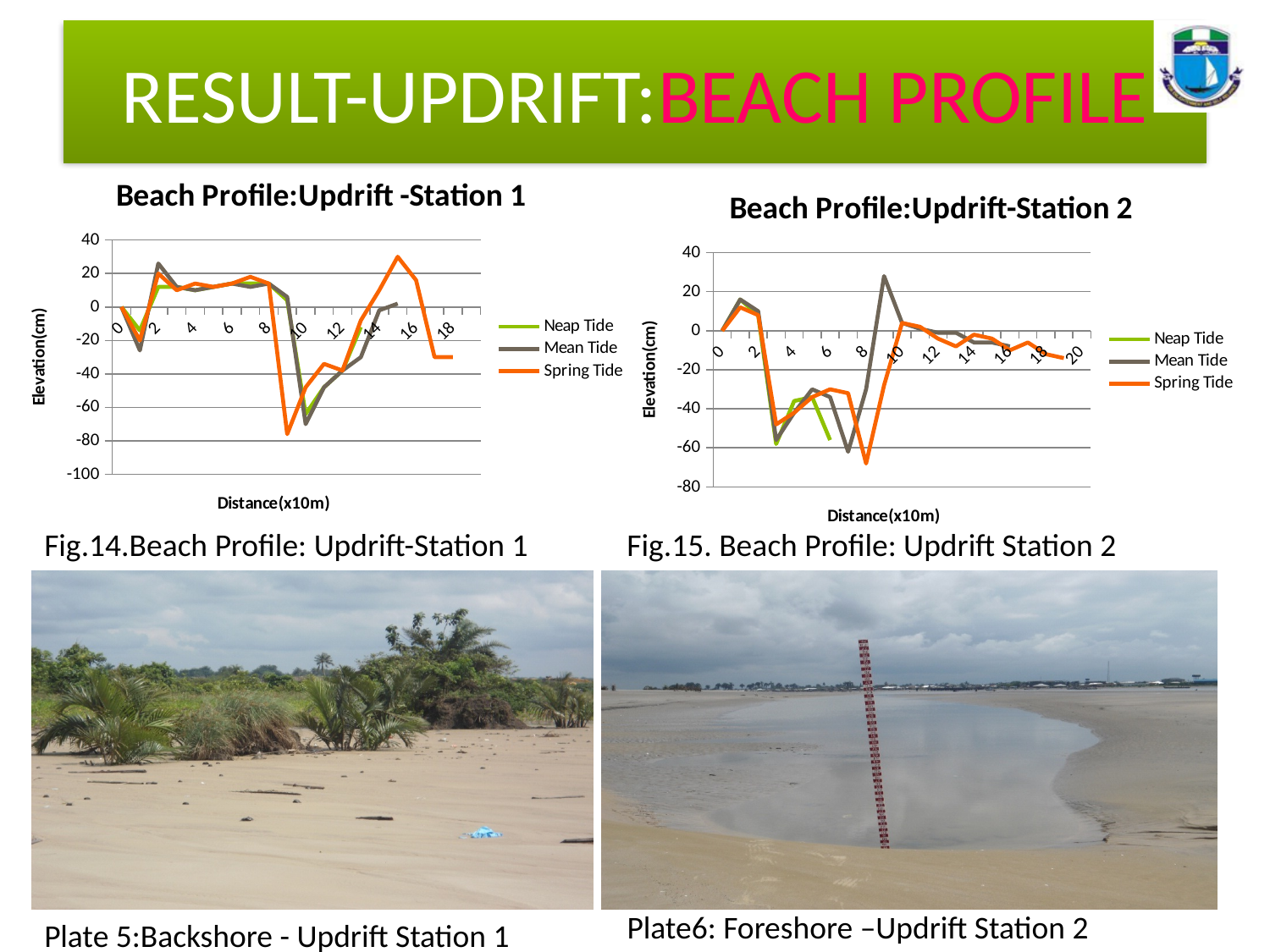
What kind of chart is the 'Beach Profile:Updrift -Station 1' chart? line chart In the 'Beach Profile:Updrift -Station 1' chart, what are the three series named in the legend? Neap Tide, Mean Tide, Spring Tide In the 'Beach Profile:Updrift-Station 2' chart, is the Mean Tide value at distance 9 greater or less than 20? greater In the 'Beach Profile:Updrift-Station 2' chart, which series reaches the highest elevation? Mean Tide In the 'Beach Profile:Updrift -Station 1' chart, is the Spring Tide value at distance 9 greater or less than -60? less In the 'Beach Profile:Updrift -Station 1' chart, is the Spring Tide value at distance 15 greater or less than 20? greater In the 'Beach Profile:Updrift -Station 1' chart, which series reaches the highest elevation? Spring Tide In the 'Beach Profile:Updrift -Station 1' chart, at distance 15, which is higher: Spring Tide or Mean Tide? Spring Tide How many series does the legend of the 'Beach Profile:Updrift-Station 2' chart list? 3 In the 'Beach Profile:Updrift-Station 2' chart, at distance 9, which is higher: Mean Tide or Spring Tide? Mean Tide What is the y-axis title of the 'Beach Profile:Updrift-Station 2' chart? Elevation(cm)